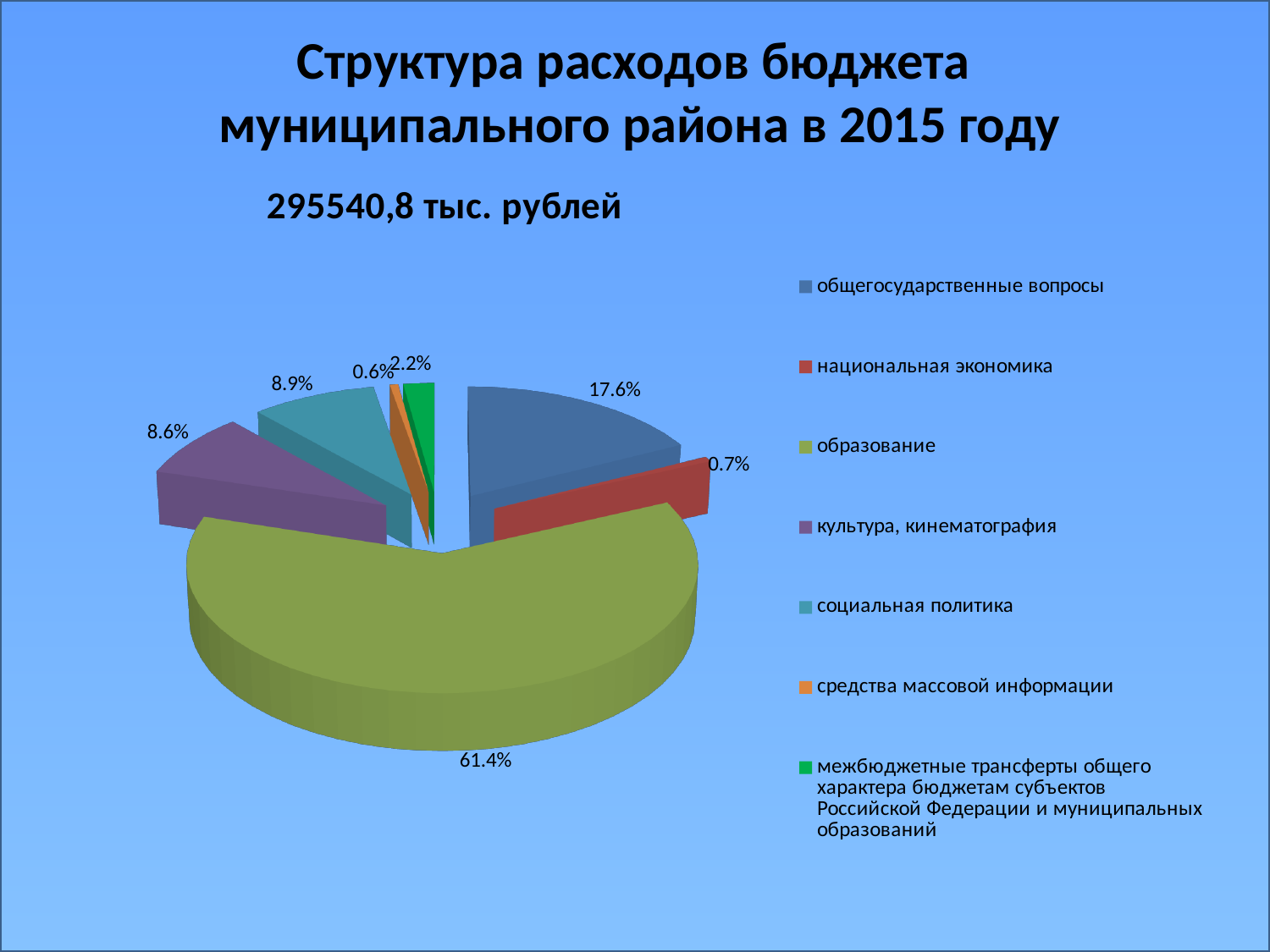
How many categories does the legend list? 7 What total amount of budget expenditure is stated on the slide? 295540,8 тыс. рублей What kind of chart is shown on the slide? pie chart What share of the budget expenditure goes to культура, кинематография? 8.6% What share of the budget expenditure goes to общегосударственные вопросы? 17.6% What share of the budget expenditure goes to образование? 61.4% Which category has the largest share of the budget expenditure? образование Which has a larger share: социальная политика or культура, кинематография? социальная политика Which category has the smallest share of the budget expenditure? средства массовой информации What share of the budget expenditure goes to социальная политика? 8.9% What is the difference in percentage points between the share for образование and the share for общегосударственные вопросы? 43.8 What share of the budget expenditure goes to средства массовой информации? 0.6%